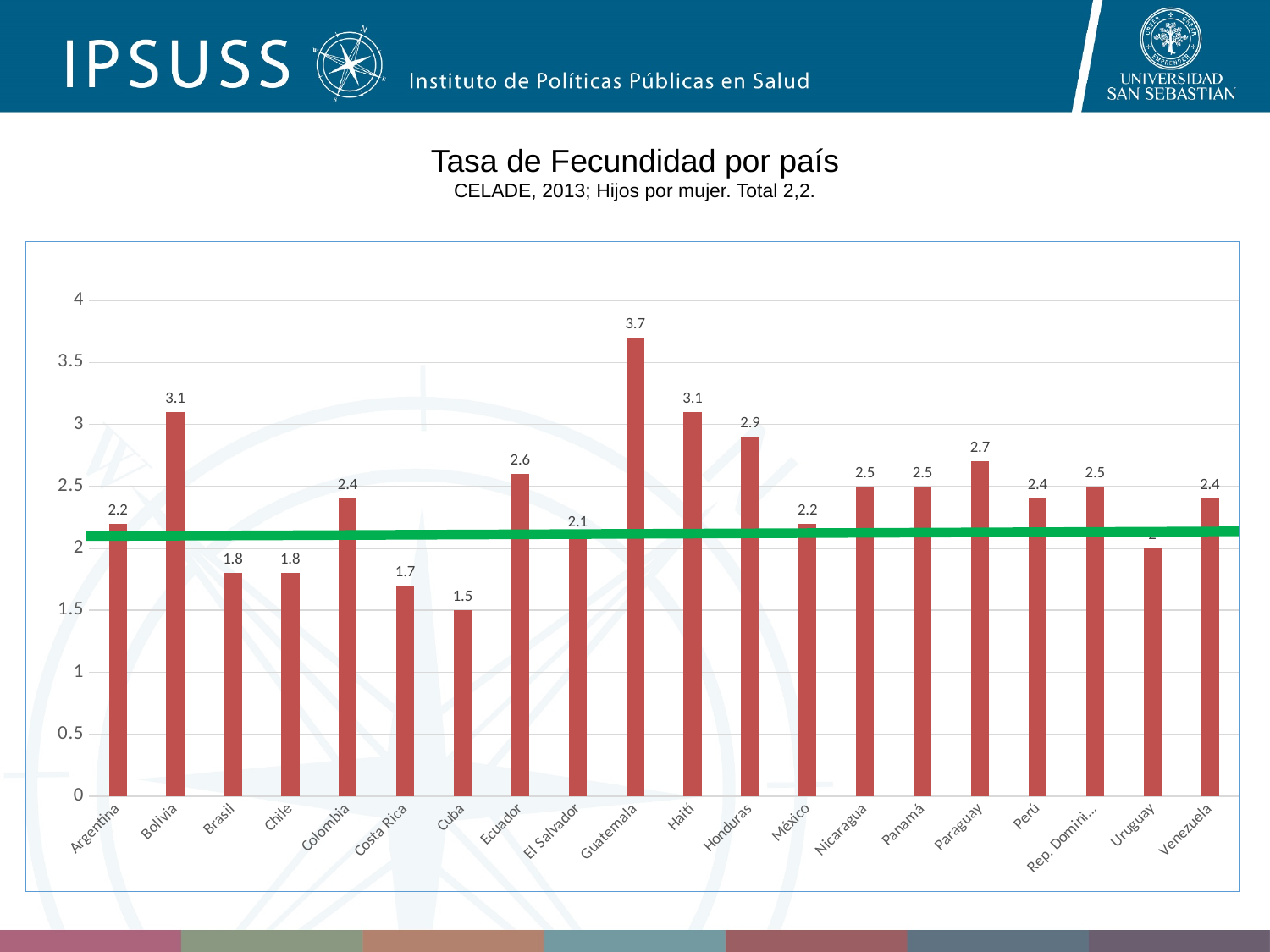
What is the title of the chart? Tasa de Fecundidad por país Which has a higher fertility rate, Bolivia or Honduras? Bolivia What is the difference between the fertility rates of Guatemala and Cuba? 2.2 How many countries are shown in the chart? 20 Which country has the lowest fertility rate in the chart? Cuba What kind of chart is used to show the fertility rates? Bar chart What is the fertility rate shown for Chile? 1.8 What is the fertility rate shown for Guatemala? 3.7 What is the difference between the fertility rates of Haití and Argentina? 0.9 Is the value for Costa Rica greater or less than 2? less What is the fertility rate shown for Ecuador? 2.6 Which country has the highest fertility rate in the chart? Guatemala